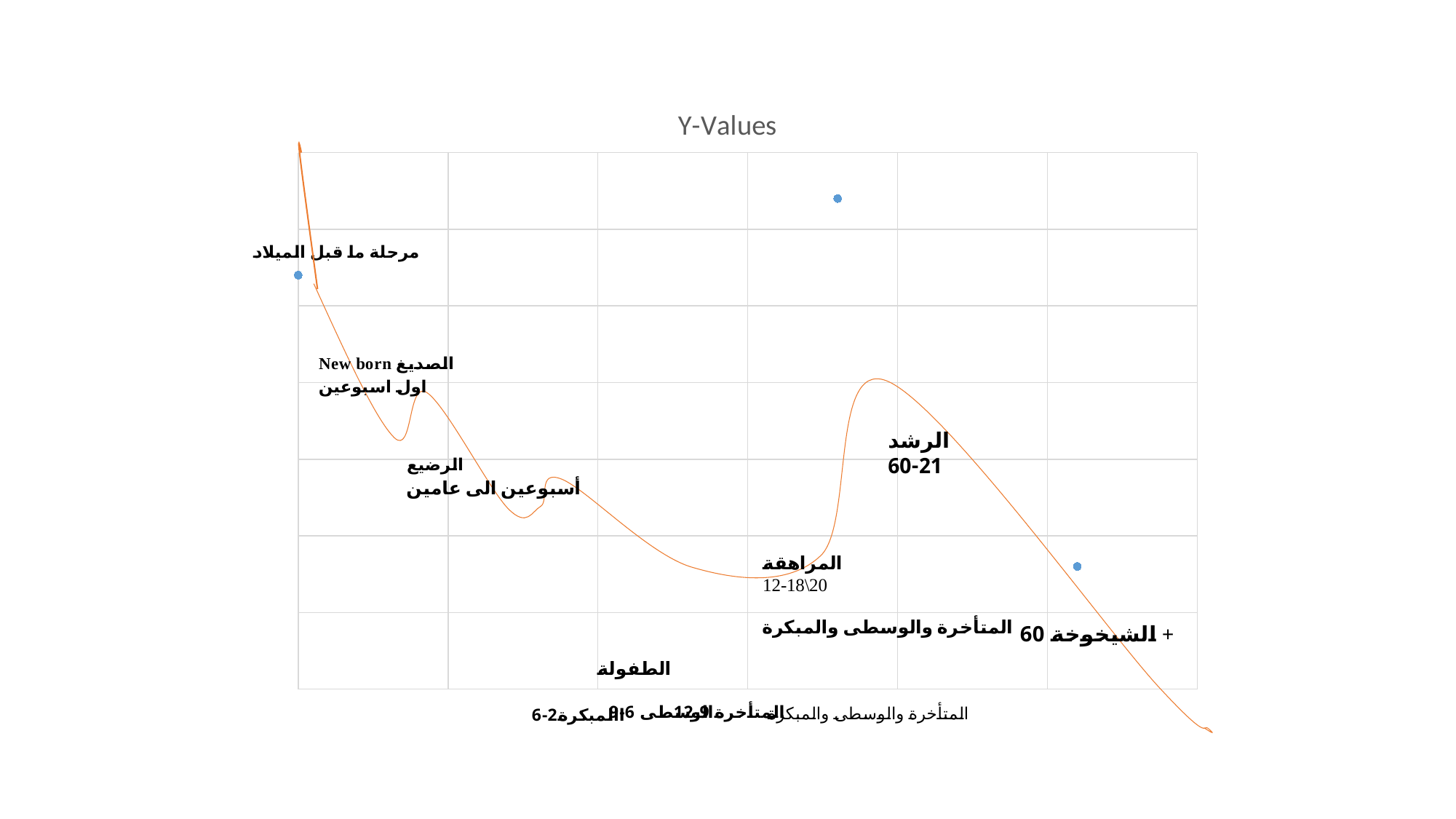
Which plotted point is the highest: the leftmost, the middle, or the rightmost? the middle Do the plotted points rise or fall from the middle point to the rightmost point? fall What colour are the plotted data points? blue Which is higher on the chart, the leftmost point or the rightmost point? the leftmost point What is the title of the chart? Y-Values What kind of chart is shown on the slide? scatter chart How many data points are plotted on the chart? 3 Which plotted point is the lowest: the leftmost, the middle, or the rightmost? the rightmost